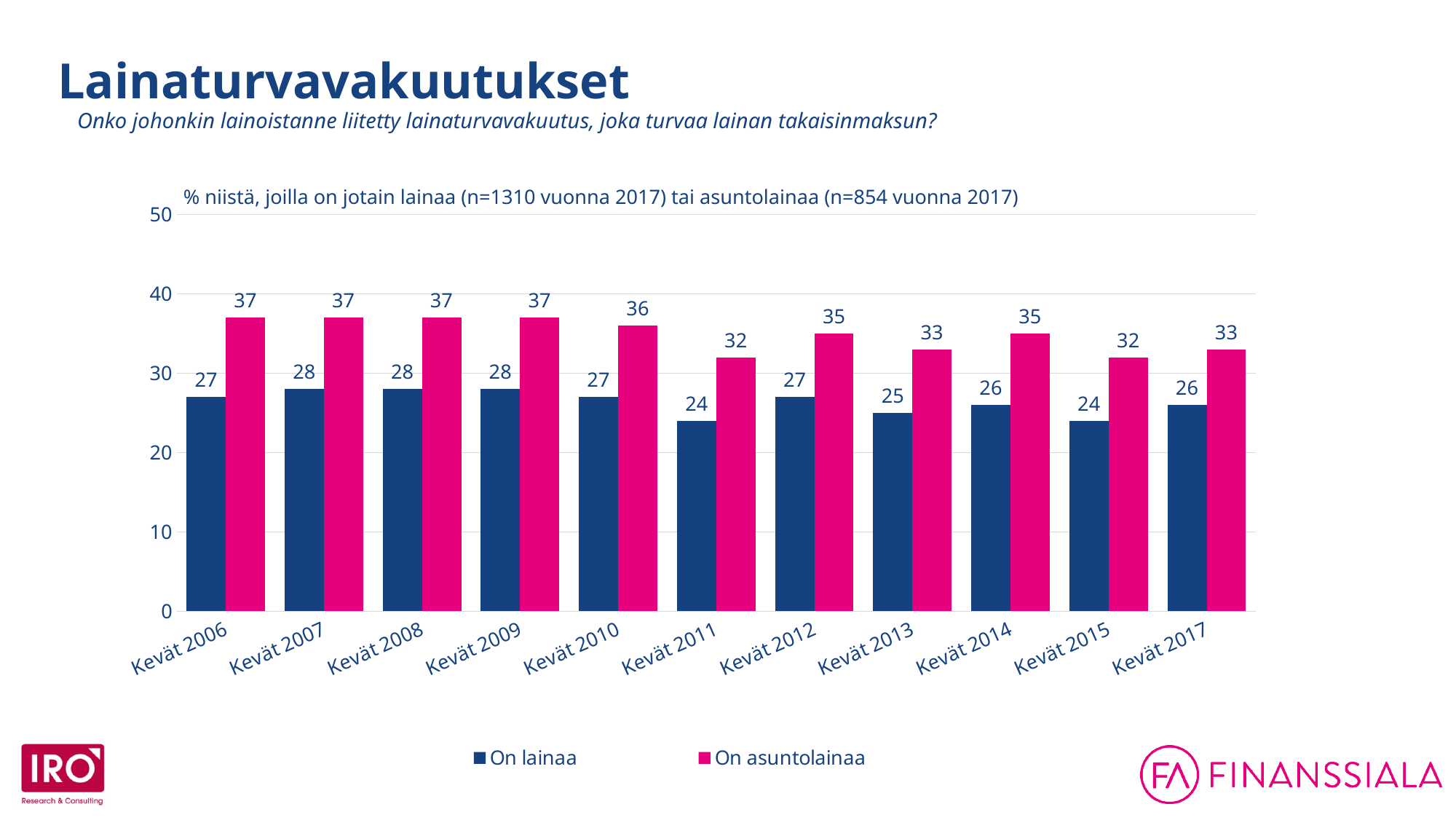
What is the difference between "On asuntolainaa" and "On lainaa" in Kevät 2006? 10 How many categories are shown on the x axis? 11 What is the difference between the "On lainaa" values for Kevät 2007 and Kevät 2015? 4 Does the "On asuntolainaa" series rise or fall from Kevät 2009 to Kevät 2011? Fall What kind of chart is shown on the slide? Bar chart What is the value for "On lainaa" in Kevät 2011? 24 Which category has the lowest value for the "On asuntolainaa" series? Kevät 2011 and Kevät 2015 What colour are the bars for the "On asuntolainaa" series? Pink What is the value for "On asuntolainaa" in Kevät 2010? 36 How many series does the legend list? 2 What is the value for "On asuntolainaa" in Kevät 2017? 33 Which is larger in Kevät 2014: "On lainaa" or "On asuntolainaa"? On asuntolainaa